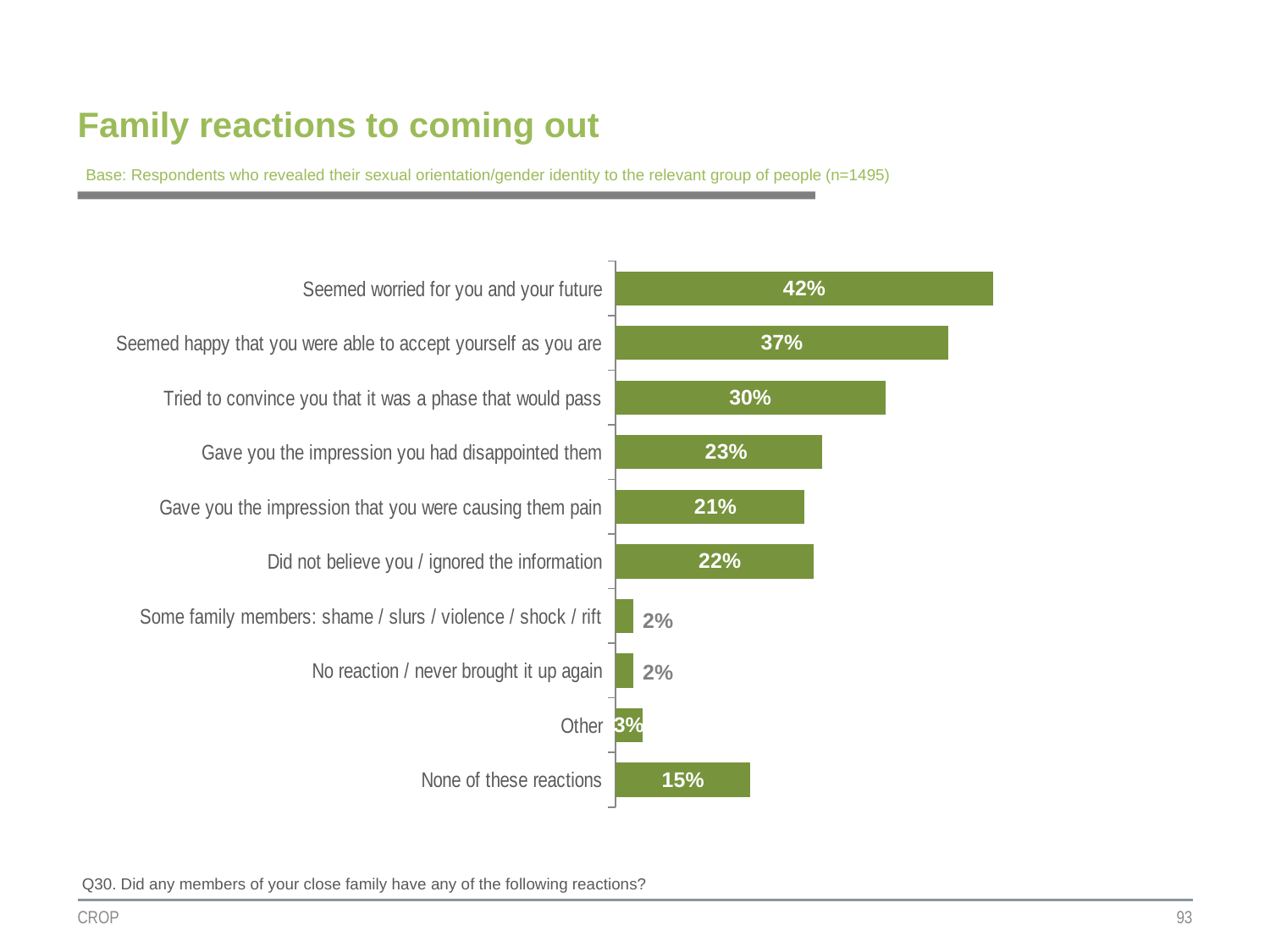
What kind of chart is shown on the slide? Bar chart What is the value for 'Other'? 3% Which family reaction has the highest percentage? Seemed worried for you and your future What percentage reported 'None of these reactions'? 15% What percentage of respondents said their family seemed worried for them and their future? 42% What is the value for 'Did not believe you / ignored the information'? 22% What is the difference between 'Seemed worried for you and your future' and 'Seemed happy that you were able to accept yourself as you are'? 5% Which is larger: 'Tried to convince you that it was a phase that would pass' or 'Gave you the impression that you were causing them pain'? Tried to convince you that it was a phase that would pass What is the title of the slide's chart? Family reactions to coming out What is the difference between 'Gave you the impression you had disappointed them' and 'None of these reactions'? 8% What is the value for 'Tried to convince you that it was a phase that would pass'? 30% How many reaction categories are shown in the chart? 10